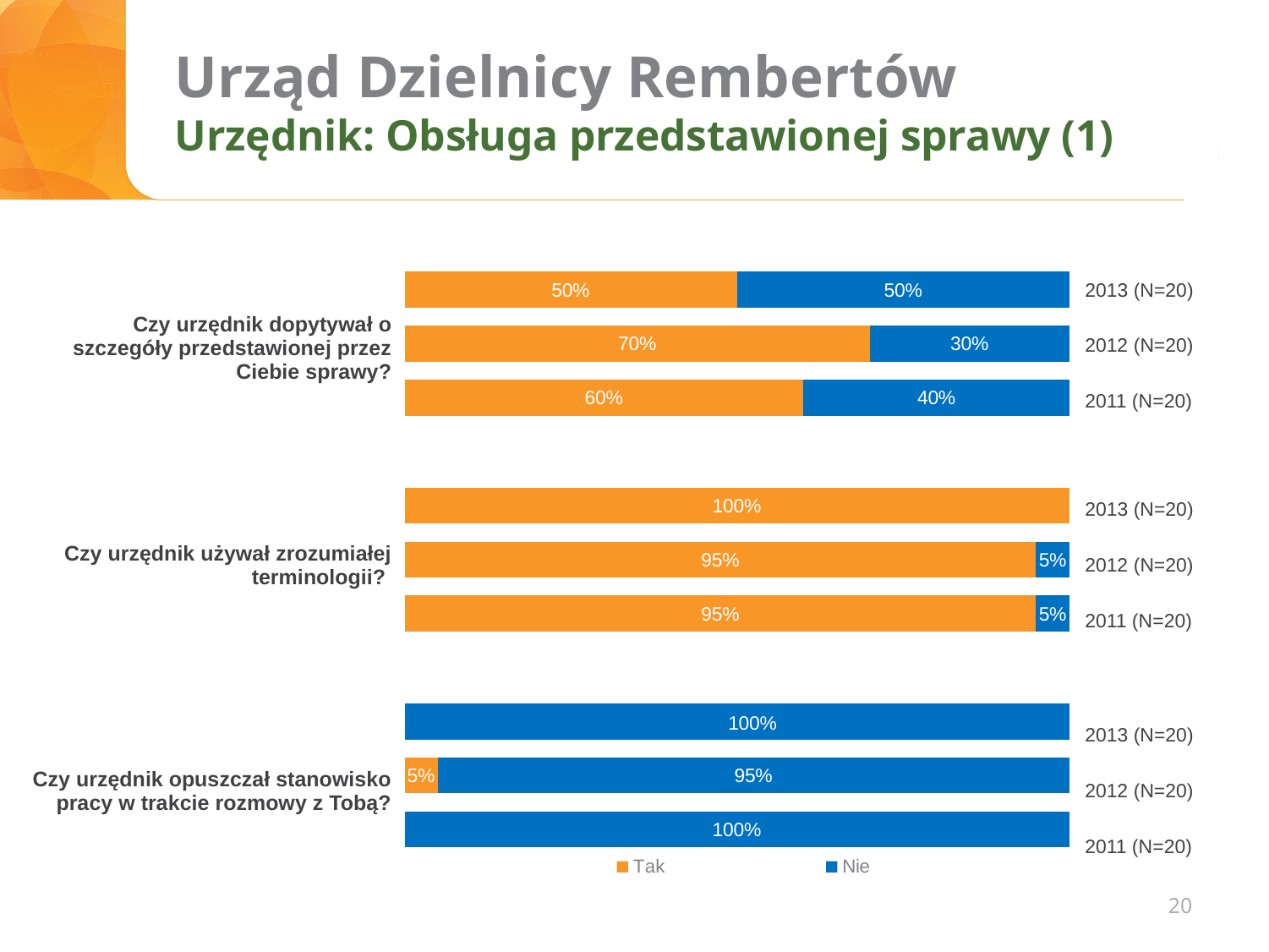
How many series does the legend list? 2 What type of chart is shown on the slide? Stacked bar chart In the chart for "Czy urzędnik dopytywał o szczegóły przedstawionej przez Ciebie sprawy?", is the "Nie" value for 2011 larger or smaller than the "Nie" value for 2013? smaller In the chart for "Czy urzędnik dopytywał o szczegóły przedstawionej przez Ciebie sprawy?", what is the difference between the "Tak" values for 2012 and 2011? 10% In the chart for "Czy urzędnik dopytywał o szczegóły przedstawionej przez Ciebie sprawy?", what is the "Tak" value for 2013 (N=20)? 50% In the chart for "Czy urzędnik dopytywał o szczegóły przedstawionej przez Ciebie sprawy?", which year has the highest "Tak" value? 2012 (N=20) In the chart for "Czy urzędnik opuszczał stanowisko pracy w trakcie rozmowy z Tobą?", what is the "Nie" value for 2012 (N=20)? 95% In the chart for "Czy urzędnik dopytywał o szczegóły przedstawionej przez Ciebie sprawy?", what is the "Nie" value for 2012 (N=20)? 30% In the chart for "Czy urzędnik opuszczał stanowisko pracy w trakcie rozmowy z Tobą?", which year has the lowest "Nie" value? 2012 (N=20) Which colour represents "Nie" in the legend? Blue In the chart for "Czy urzędnik używał zrozumiałej terminologii?", what is the "Nie" value for 2011 (N=20)? 5% In the chart for "Czy urzędnik używał zrozumiałej terminologii?", what is the "Tak" value for 2013 (N=20)? 100%